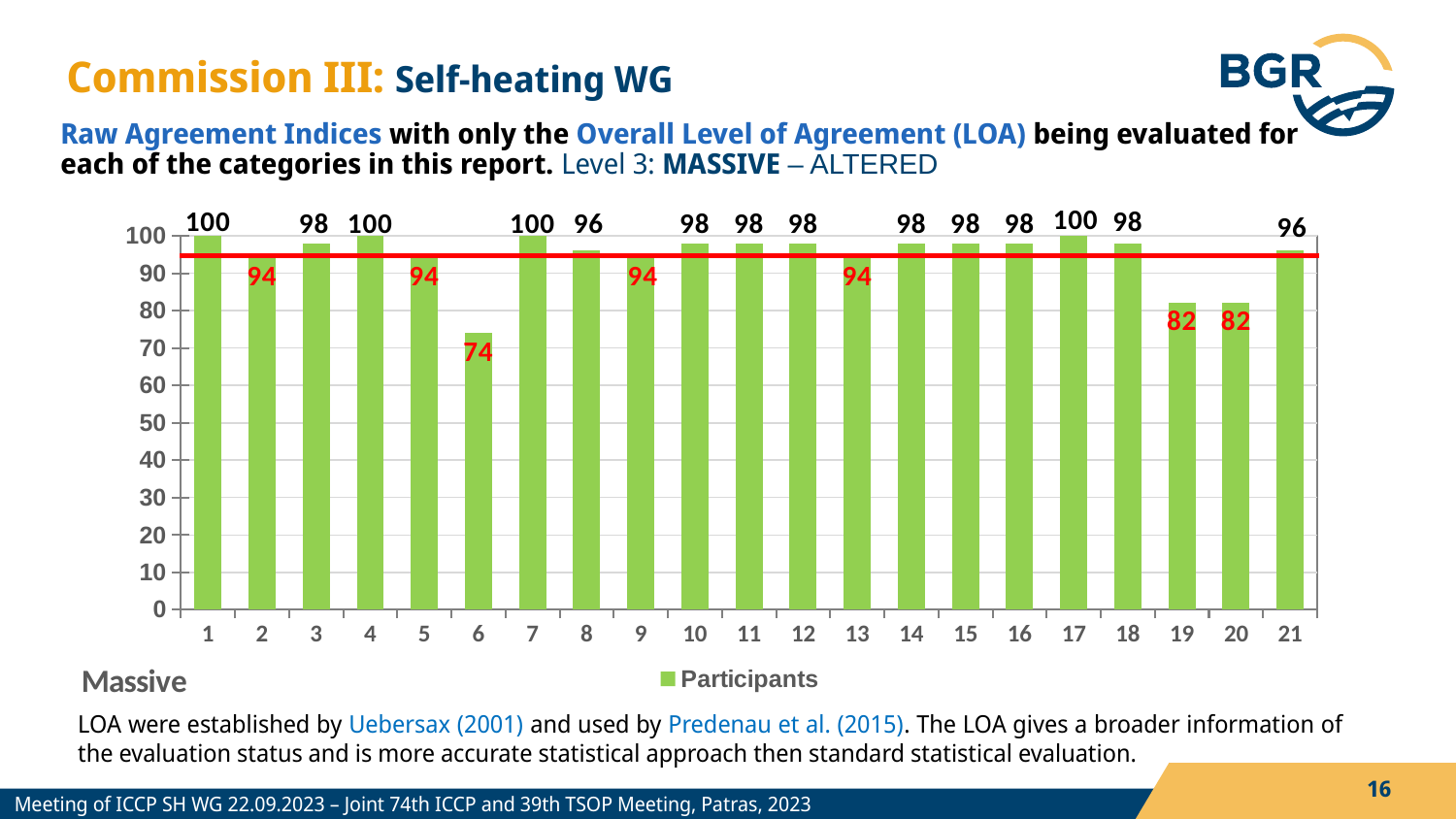
Which is larger, the value for participant 8 or participant 9? Participant 8 What is the difference between the values for participant 3 and participant 20? 16 What is the highest value shown on the chart? 100 What kind of chart is shown on the slide? Bar chart How many participants are shown on the x axis? 21 How many series does the legend list? 1 What is the value for participant 13? 94 What is the value for participant 21? 96 What is the value for participant 6? 74 Which participant has the lowest value? 6 What is the difference between the values for participant 1 and participant 6? 26 What is the value for participant 19? 82